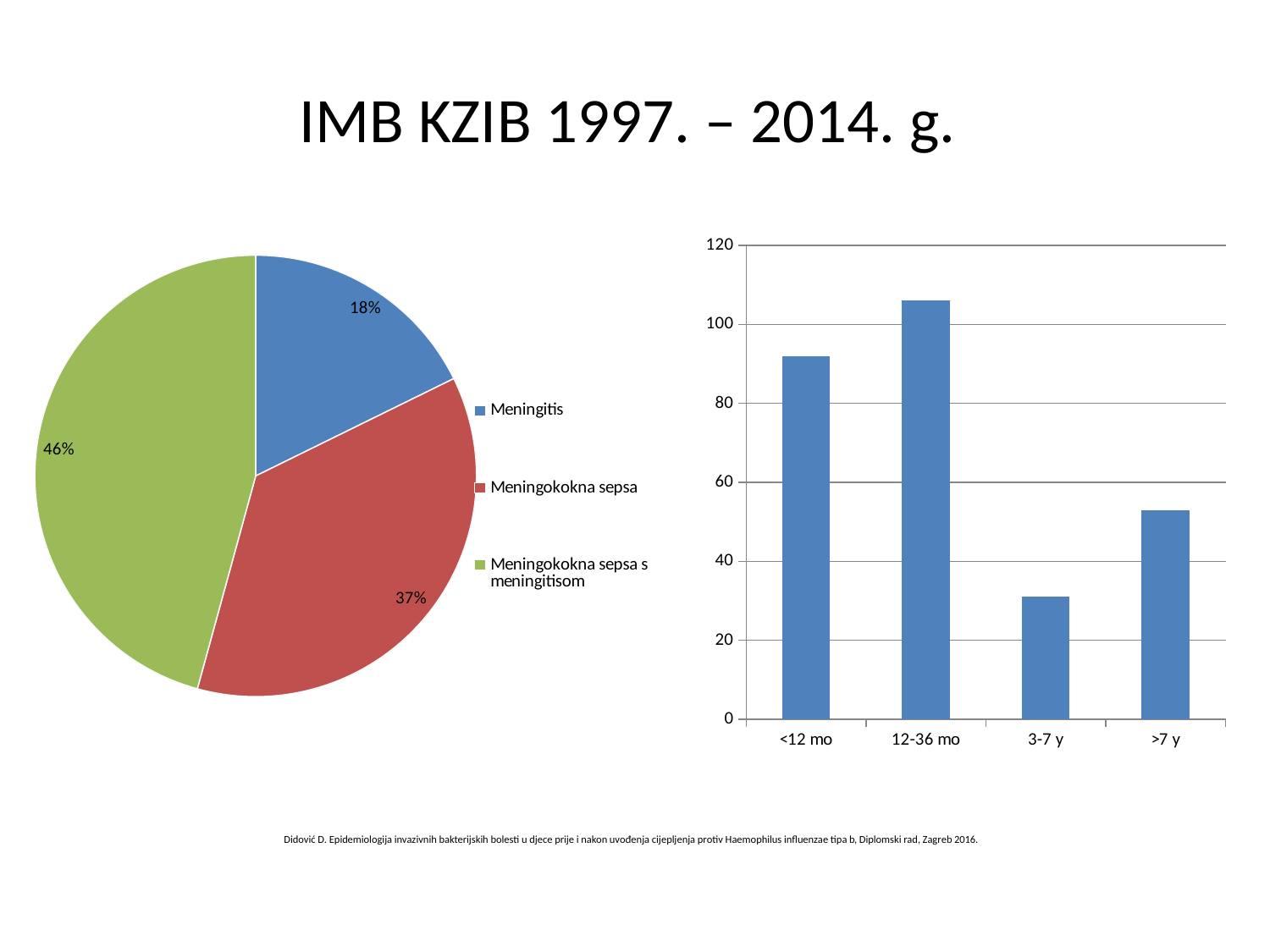
On the bar chart on the right, is the value for >7 y greater or less than 60? less On the pie chart on the left, what is the difference in percentage points between Meningokokna sepsa s meningitisom and Meningitis? 28 On the pie chart on the left, which category has the smallest share? Meningitis On the bar chart on the right, is the value for 12-36 mo greater or less than 100? greater On the pie chart on the left, which category has the largest share? Meningokokna sepsa s meningitisom On the pie chart on the left, what share does Meningokokna sepsa have? 37% On the pie chart on the left, what share does Meningokokna sepsa s meningitisom have? 46% On the pie chart on the left, how many entries does the legend list? 3 On the bar chart on the right, which category has the highest bar? 12-36 mo On the bar chart on the right, which category has the lowest bar? 3-7 y On the pie chart on the left, what share does Meningitis have? 18% On the bar chart on the right, how many categories are shown on the x axis? 4